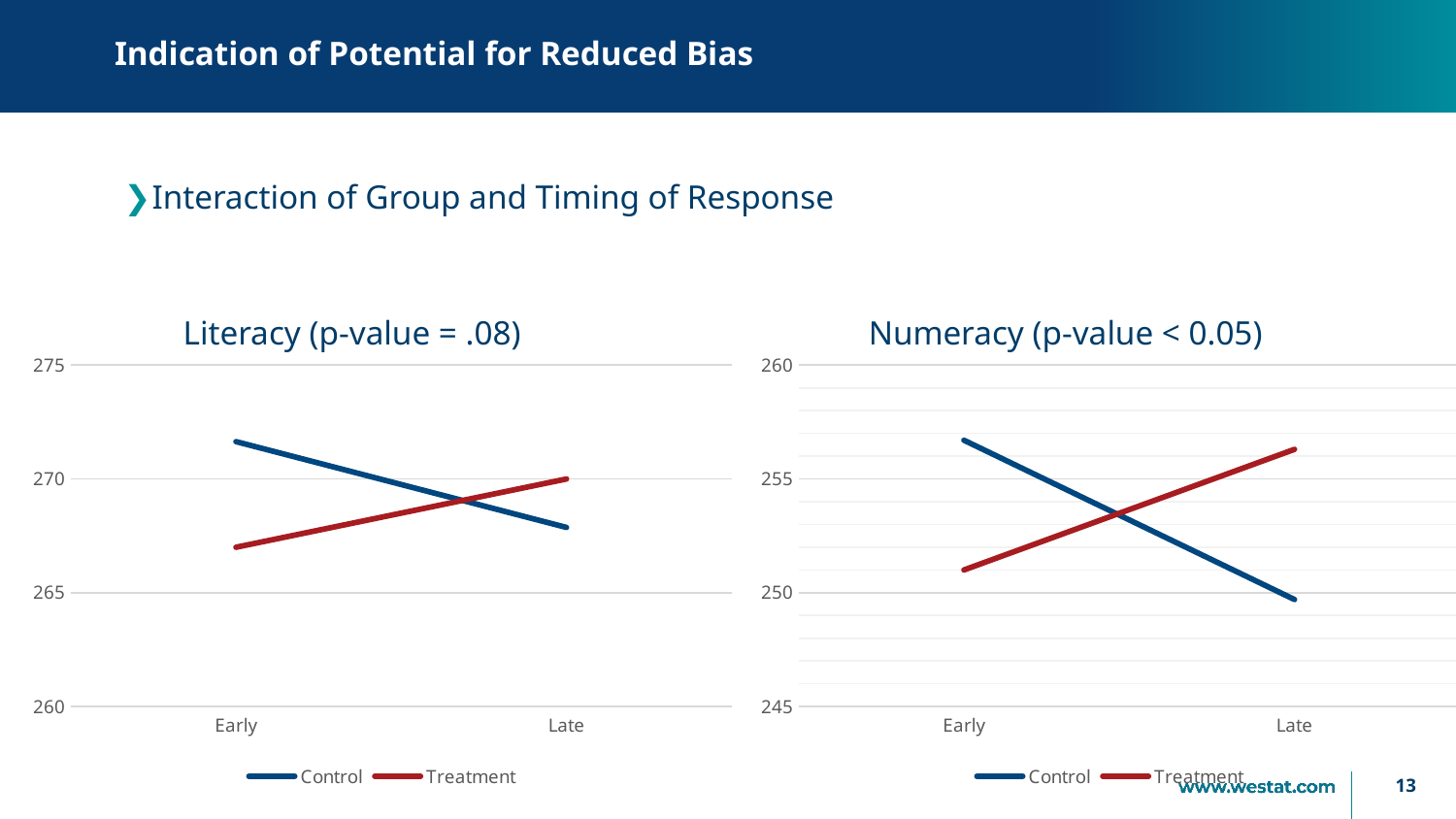
In the Numeracy (p-value < 0.05) chart, is the Control value at Early greater or less than 255? greater What kind of chart is the Literacy (p-value = .08) chart? line chart In the Numeracy (p-value < 0.05) chart, which group has the higher value at Late, Control or Treatment? Treatment In the Literacy (p-value = .08) chart, is the Treatment value at Early greater or less than 270? less How many series does the legend of the Numeracy (p-value < 0.05) chart list? 2 In the Literacy (p-value = .08) chart, does the Control line rise or fall from Early to Late? fall What colour is the Treatment line in the Literacy (p-value = .08) chart? red In the Literacy (p-value = .08) chart, which group has the higher value at Early, Control or Treatment? Control How many categories are on the x axis of the Literacy (p-value = .08) chart? 2 In the Numeracy (p-value < 0.05) chart, does the Treatment line rise or fall from Early to Late? rise In the Literacy (p-value = .08) chart, is the Control value at Early greater or less than 270? greater